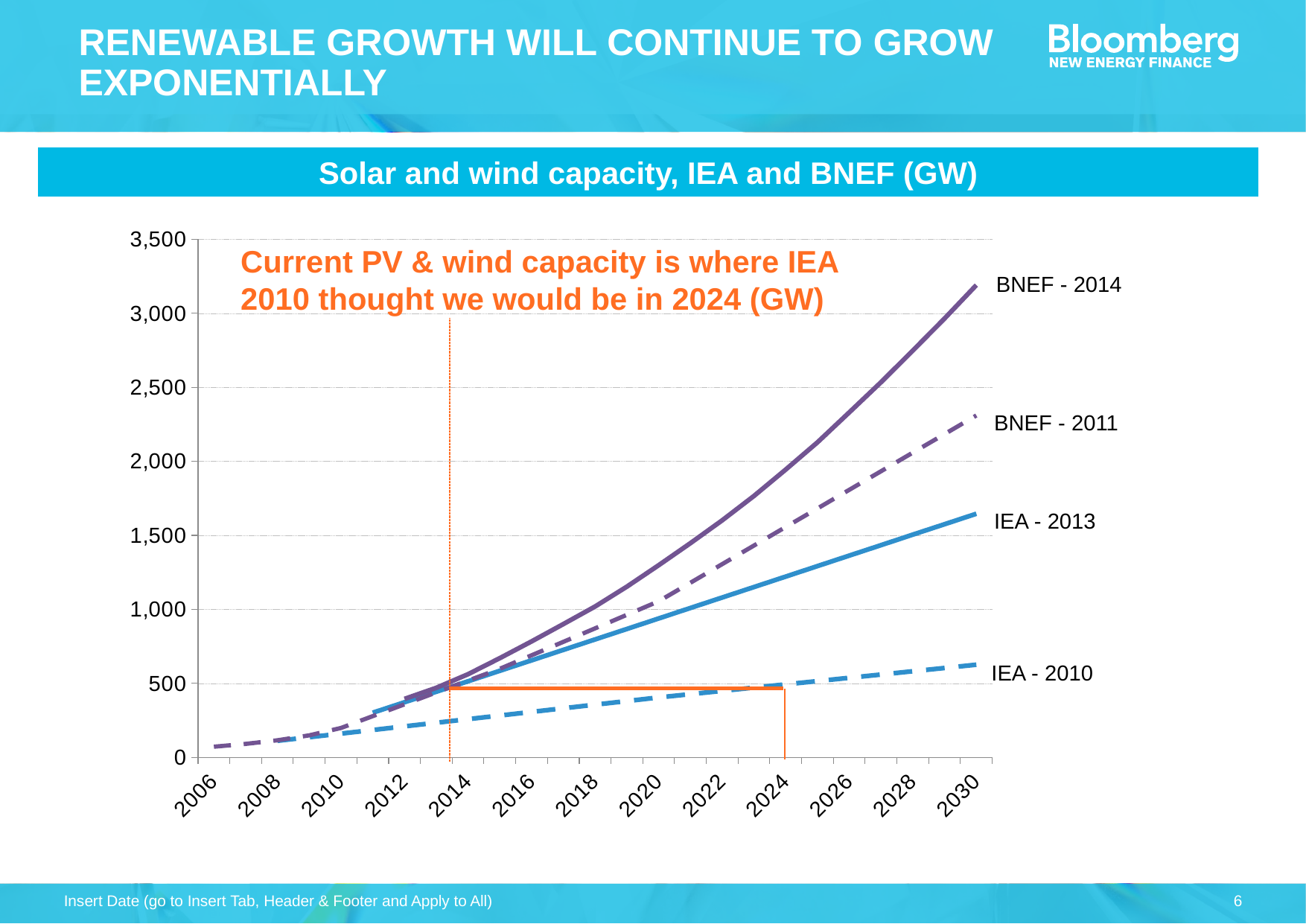
How many series are plotted on the chart? 4 Which series has the lowest value in 2030? IEA - 2010 Is the value for BNEF - 2014 in 2030 greater or less than 3,000? greater What is the title of the chart? Solar and wind capacity, IEA and BNEF (GW) Is the value for BNEF - 2011 in 2030 greater or less than 2,500? less Is the value for IEA - 2010 in 2030 greater or less than 1,000? less Do the values for BNEF - 2014 rise or fall from 2014 to 2030? rise How many year labels are shown on the x axis? 13 In 2030, which is larger: BNEF - 2014 or IEA - 2013? BNEF - 2014 Which series has the highest value in 2030? BNEF - 2014 What kind of chart is shown on the slide? line chart